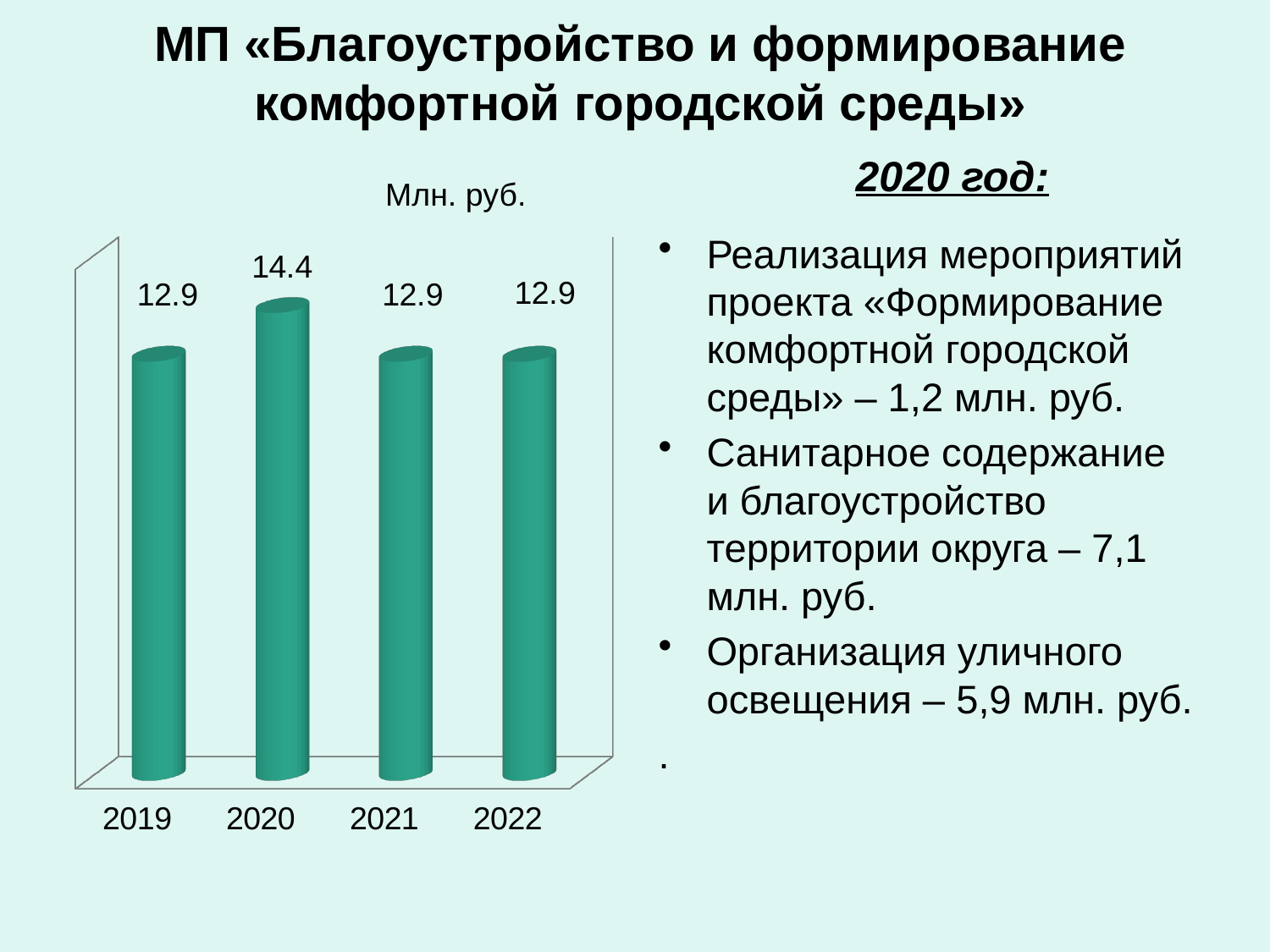
Do the values for 2020, 2021 and 2022 rise or fall from 2020 to 2021? fall How many years are shown on the chart? 4 What colour are the bars on the chart? green What is the difference between the values for 2020 and 2021? 1.5 Which is larger, the value for 2020 or the value for 2019? 2020 What is the chart's title? Млн. руб. Which year has the highest value? 2020 What kind of chart is shown on the slide? bar chart What is the value for 2020? 14.4 Are the values for 2021 and 2022 the same? yes What is the value for 2019? 12.9 What is the value for 2022? 12.9